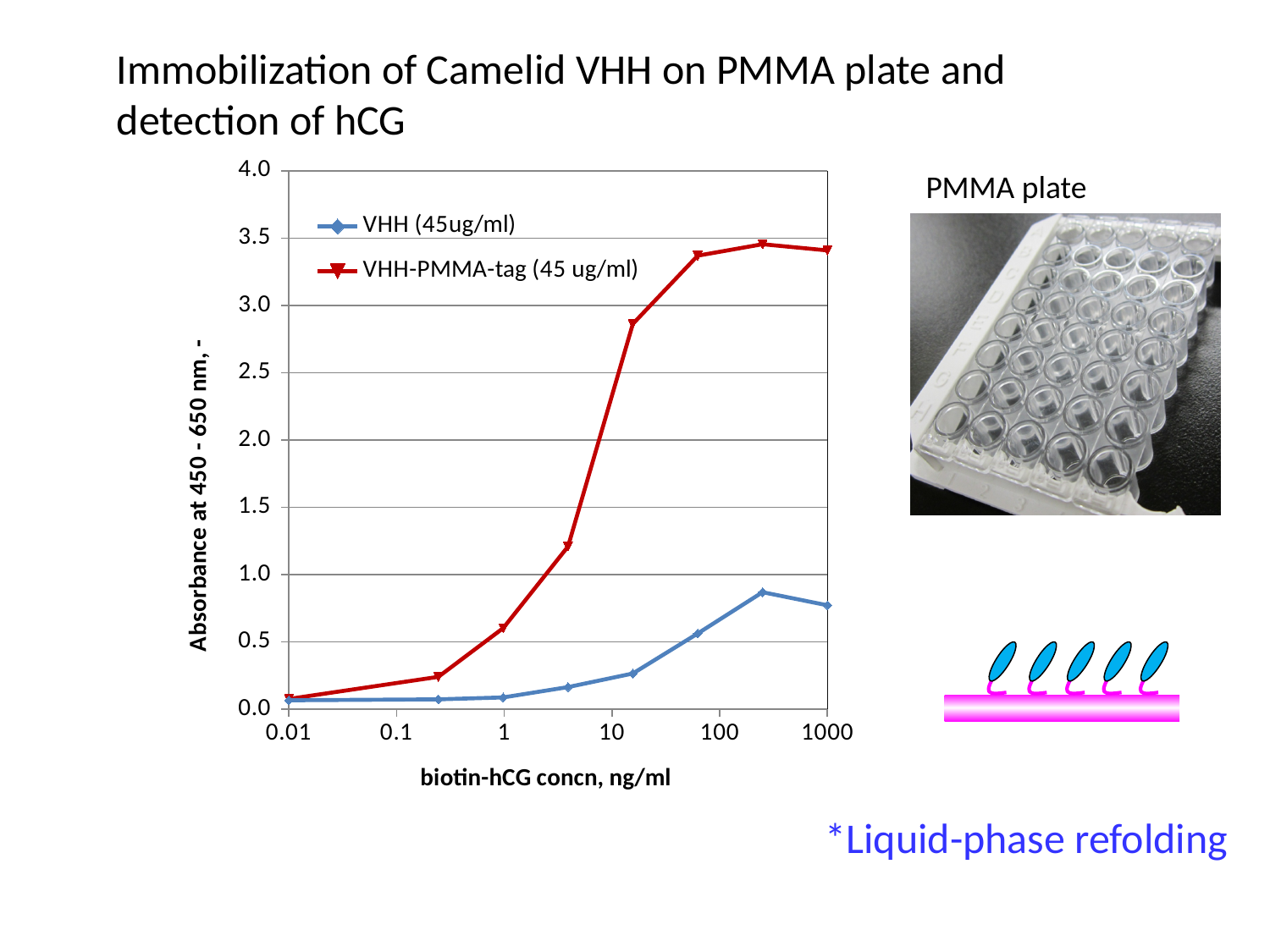
How many data points are plotted for the VHH-PMMA-tag (45 ug/ml) series? 8 Is the absorbance for VHH (45ug/ml) at 1000 ng/ml greater or less than 1.0? less Is the absorbance for VHH-PMMA-tag (45 ug/ml) at 1000 ng/ml greater or less than 3.0? greater What is the title of the y axis? Absorbance at 450 - 650 nm, - Which series reaches the higher absorbance overall, VHH (45ug/ml) or VHH-PMMA-tag (45 ug/ml)? VHH-PMMA-tag (45 ug/ml) Does the absorbance for VHH-PMMA-tag (45 ug/ml) generally rise or fall as biotin-hCG concentration increases? rise What are the two series named in the legend? VHH (45ug/ml) and VHH-PMMA-tag (45 ug/ml) Is the absorbance for VHH (45ug/ml) at 0.01 ng/ml greater or less than 0.5? less At 1 ng/ml biotin-hCG, which series has the larger absorbance, VHH (45ug/ml) or VHH-PMMA-tag (45 ug/ml)? VHH-PMMA-tag (45 ug/ml) How many series does the legend list? 2 What kind of chart is shown on the slide? line chart